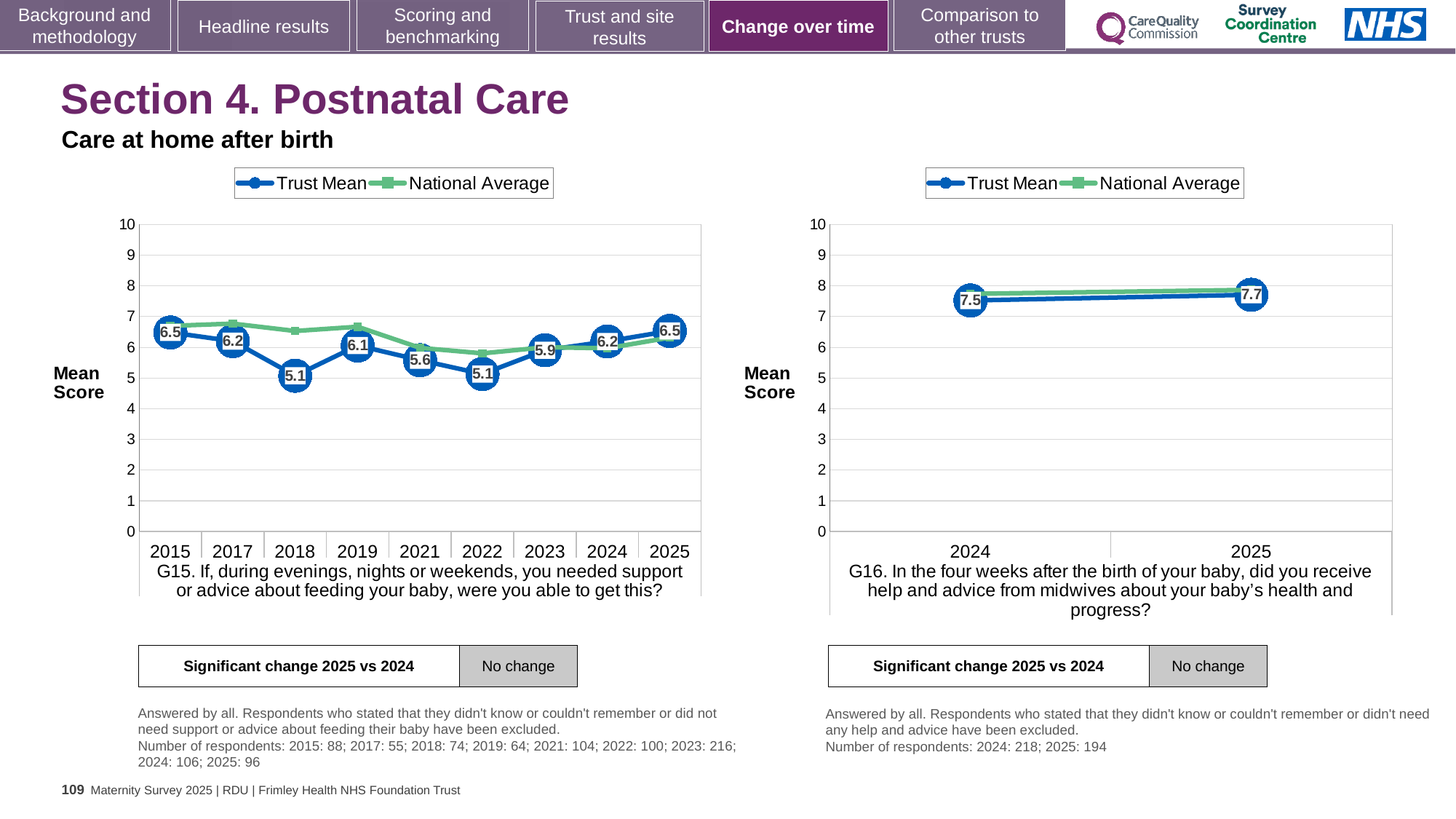
In the left chart (G15), what is the Trust Mean score for 2025? 6.5 In the right chart (G16), does the Trust Mean rise or fall from 2024 to 2025? Rise How many years are plotted on the x axis of the left chart (G15)? 9 In the left chart (G15), which year has the higher Trust Mean score, 2018 or 2019? 2019 In the right chart (G16), what is the difference between the Trust Mean scores for 2025 and 2024? 0.2 What kind of chart is the right chart (G16)? Line chart In the right chart (G16), what is the Trust Mean score for 2024? 7.5 In the left chart (G15), is the National Average value for 2018 greater or less than 6? greater In the left chart (G15), what is the Trust Mean score for 2018? 5.1 In the right chart (G16), what is the Trust Mean score for 2025? 7.7 How many series does the legend of the right chart (G16) list? 2 In the left chart (G15), what is the difference between the Trust Mean scores for 2025 and 2024? 0.3